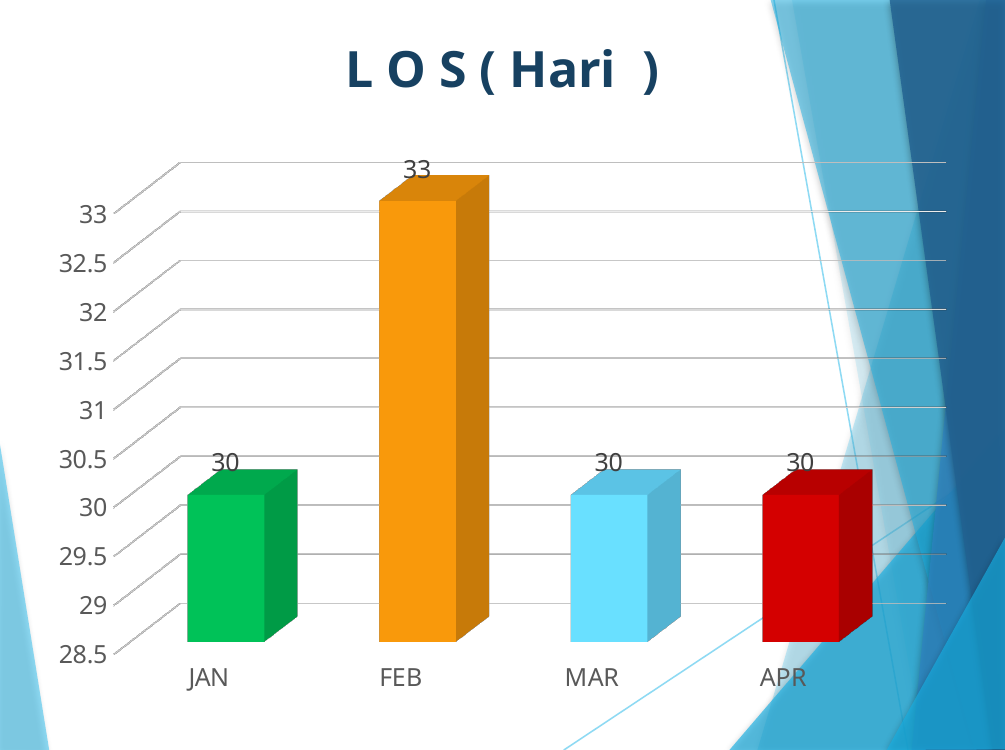
Is the value for FEB greater or less than 32? greater What colour is the bar for FEB? orange Which month has the highest value? FEB Is the value for MAR greater or less than 31? less What is the title of the chart? L O S ( Hari ) How many months are shown on the x axis? 4 Which is larger, the value for FEB or the value for JAN? FEB What is the value for APR? 30 What is the value for FEB? 33 What is the value for JAN? 30 What is the difference between the values for FEB and MAR? 3 What kind of chart is shown on the slide? bar chart